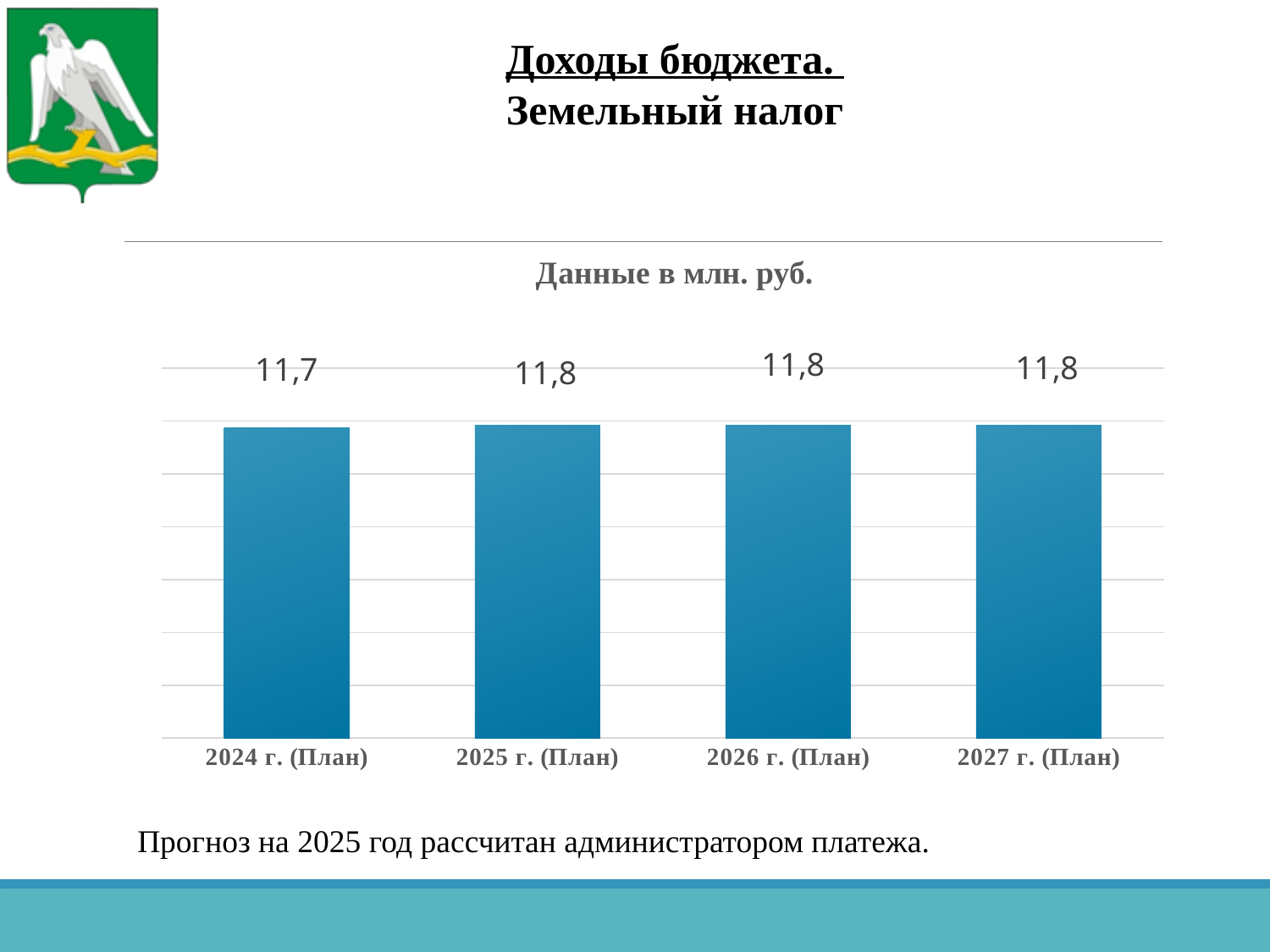
What is the value for 2024 г. (План)? 11,7 What colour are the bars in the chart? blue What is the value for 2027 г. (План)? 11,8 What is the value for 2025 г. (План)? 11,8 How many categories are shown on the x axis? 4 What is the title of the chart? Данные в млн. руб. What kind of chart is shown on the slide? bar chart Which category has the lowest value? 2024 г. (План) Which is larger, the value for 2024 г. (План) or the value for 2025 г. (План)? 2025 г. (План) What is the value for 2026 г. (План)? 11,8 What is the difference between the values for 2025 г. (План) and 2024 г. (План)? 0,1 Do the values rise or fall from 2024 г. (План) to 2025 г. (План)? rise